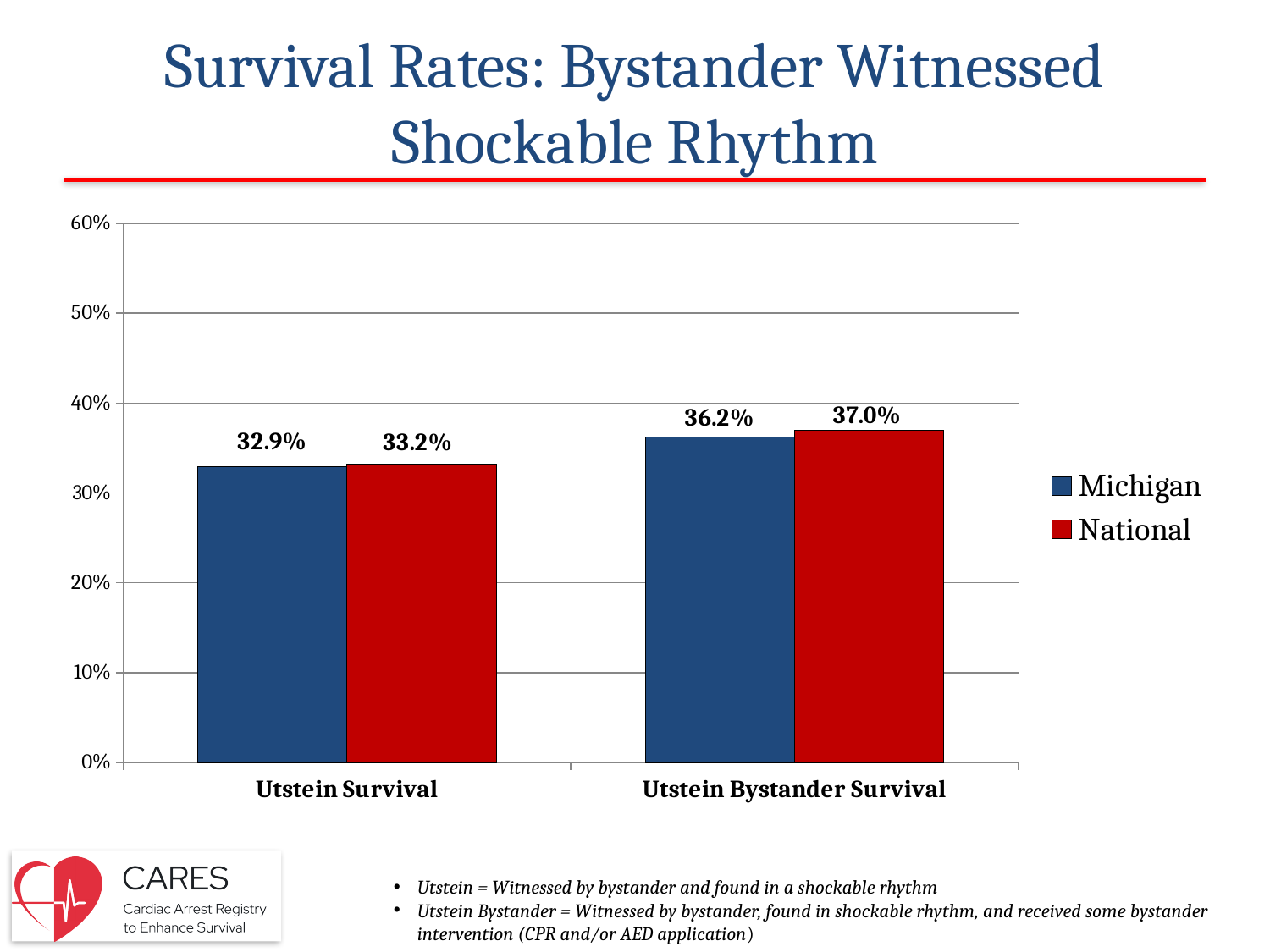
What kind of chart is shown on the slide? bar chart What is the Michigan value for Utstein Bystander Survival? 36.2% Which bar has the highest value on the chart? National, Utstein Bystander Survival What is the National value for Utstein Survival? 33.2% Which bar has the lowest value on the chart? Michigan, Utstein Survival What is the difference between the Michigan values for Utstein Bystander Survival and Utstein Survival? 3.3% What is the difference between the National and Michigan values for Utstein Bystander Survival? 0.8% What is the National value for Utstein Bystander Survival? 37.0% How many series does the legend list? 2 What is the Michigan value for Utstein Survival? 32.9% How many categories are shown on the x axis? 2 Is the Michigan value for Utstein Bystander Survival greater or less than 40%? less